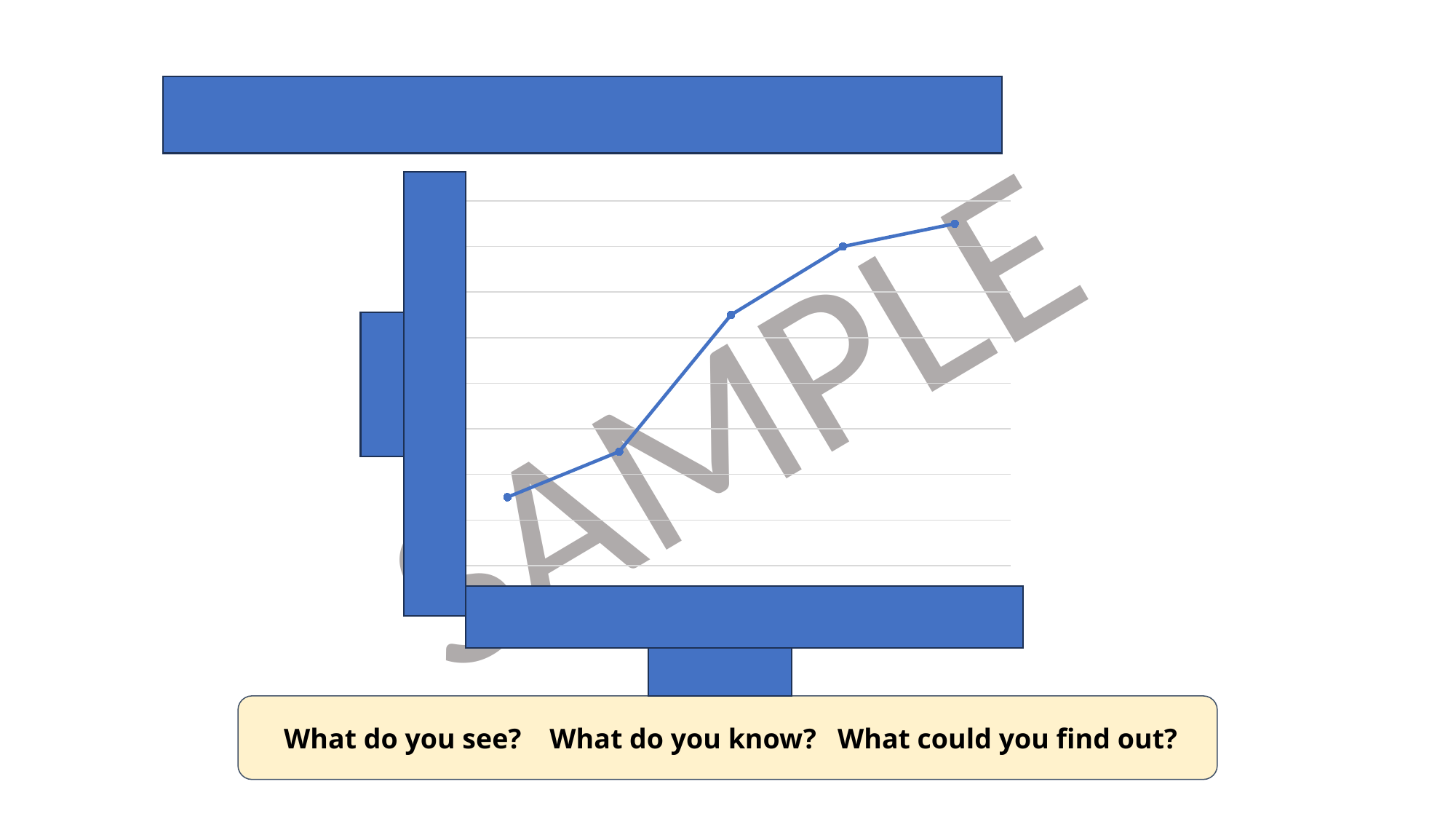
Which plotted point is the lowest on the chart, the leftmost or the rightmost? the leftmost Do the plotted values rise or fall from left to right along the x axis? rise What colour is the plotted line? blue How many lines are plotted on the chart? 1 Which is higher, the leftmost point or the rightmost point on the line? the rightmost point How many data points are plotted on the line? 5 What kind of chart is shown on the slide? line chart